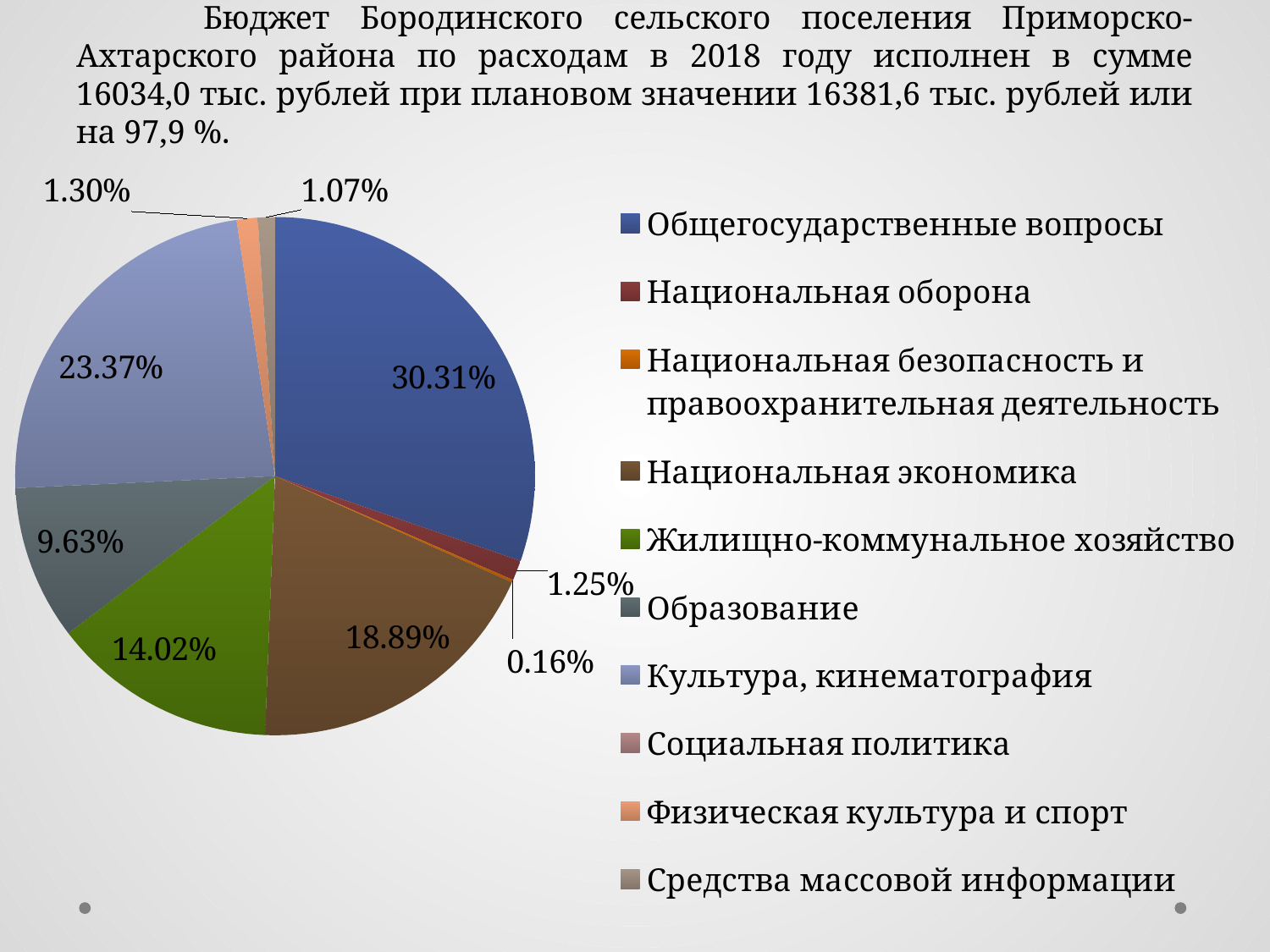
Какую долю расходов составляет «Национальная оборона»? 1.25% Какая категория расходов имеет наибольшую долю на диаграмме? Общегосударственные вопросы Какую долю расходов составляет «Культура, кинематография»? 23.37% Какую долю расходов составляют «Общегосударственные вопросы» на круговой диаграмме? 30.31% Какую долю расходов составляет «Жилищно-коммунальное хозяйство»? 14.02% На сколько процентных пунктов доля «Общегосударственных вопросов» больше доли «Культуры, кинематографии»? 6.94 Сколько категорий перечислено в легенде диаграммы? 10 Какую долю расходов составляет «Образование»? 9.63% Какой тип диаграммы показан на слайде? Круговая диаграмма Что больше: доля «Национальной экономики» или доля «Жилищно-коммунального хозяйства»? Национальная экономика Какая категория расходов имеет наименьшую подписанную долю на диаграмме? Национальная безопасность и правоохранительная деятельность Какую долю расходов составляет «Национальная экономика»? 18.89%